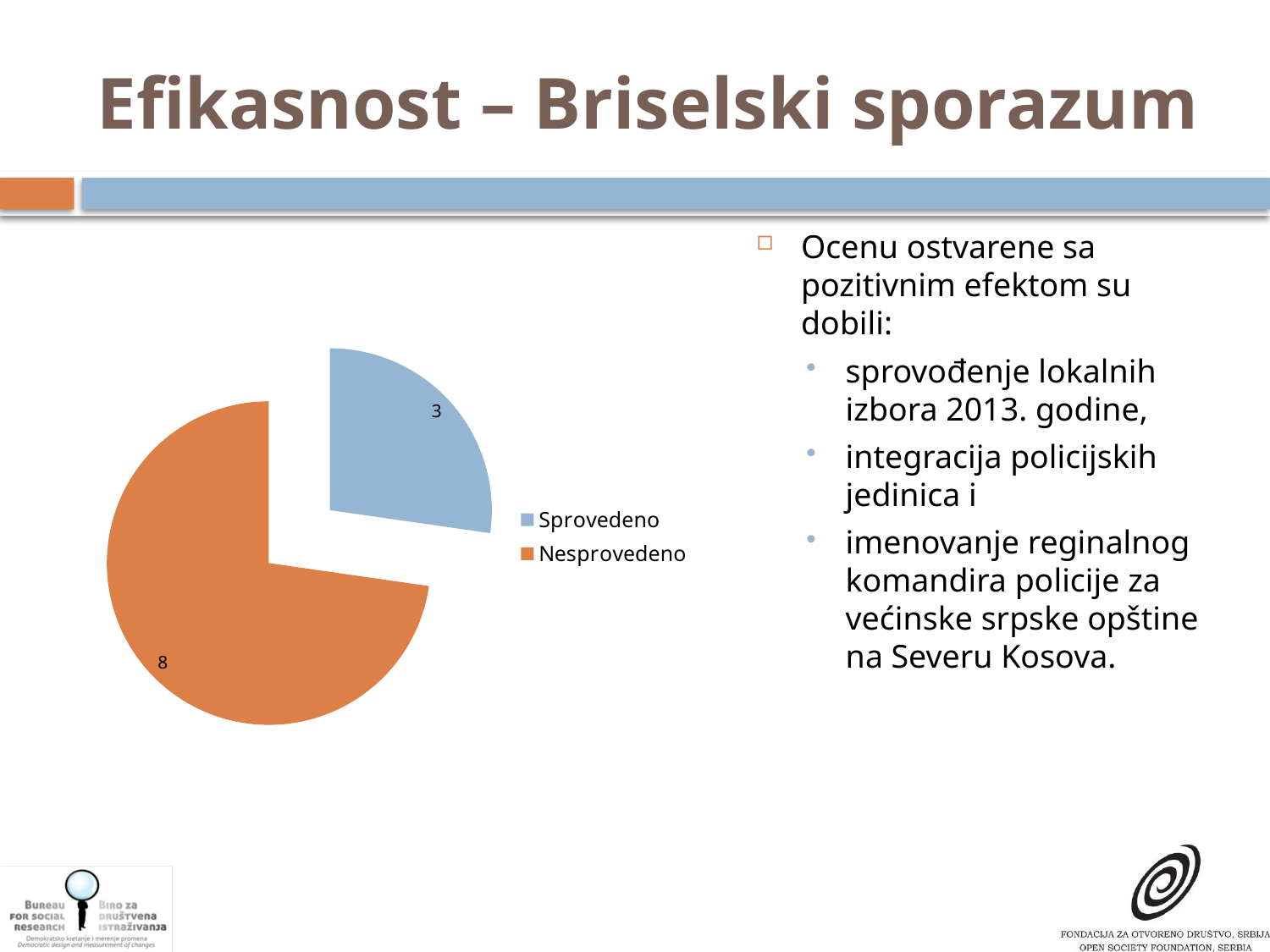
How many slices does the pie chart have? 2 Which slice of the pie chart is the smallest? Sprovedeno Which slice of the pie chart is the largest? Nesprovedeno Which is larger, Sprovedeno or Nesprovedeno? Nesprovedeno What is the difference between the values for Nesprovedeno and Sprovedeno? 5 What is the value for Sprovedeno in the pie chart? 3 What is the total of all slices in the pie chart? 11 What type of chart is shown on the slide? pie chart What fraction of the pie does Sprovedeno represent? 3/11 What is the value for Nesprovedeno in the pie chart? 8 How many entries does the legend of the pie chart list? 2 What colour is the Nesprovedeno slice in the pie chart? orange